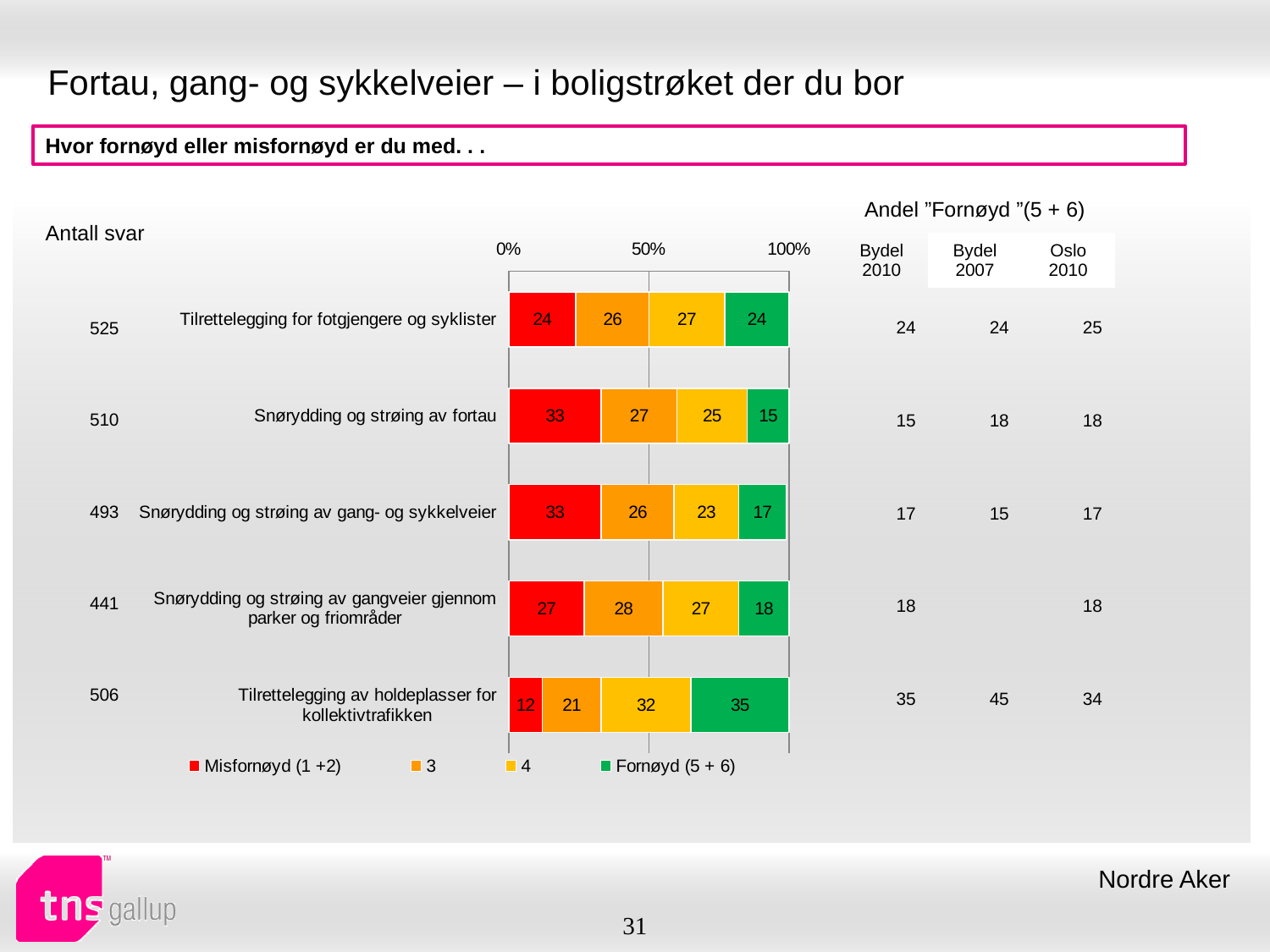
What is the 'Misfornøyd (1 +2)' value for 'Snørydding og strøing av fortau'? 33 How many series does the chart legend list? 4 What is the total of the stacked bar for 'Snørydding og strøing av fortau'? 100 What kind of chart is shown on the slide? Stacked bar chart How many categories (rows) are plotted in the chart? 5 Which category has the lowest 'Misfornøyd (1 +2)' value? Tilrettelegging av holdeplasser for kollektivtrafikken Which category has the highest 'Fornøyd (5 + 6)' value? Tilrettelegging av holdeplasser for kollektivtrafikken What is the value of series '4' for 'Snørydding og strøing av gang- og sykkelveier'? 23 What is the 'Fornøyd (5 + 6)' value for 'Tilrettelegging av holdeplasser for kollektivtrafikken'? 35 What colour represents the 'Fornøyd (5 + 6)' series in the chart? Green Which is larger: the 'Misfornøyd (1 +2)' value for 'Tilrettelegging for fotgjengere og syklister' or for 'Snørydding og strøing av gangveier gjennom parker og friområder'? Snørydding og strøing av gangveier gjennom parker og friområder What is the difference between the 'Fornøyd (5 + 6)' values for 'Tilrettelegging av holdeplasser for kollektivtrafikken' and 'Snørydding og strøing av fortau'? 20